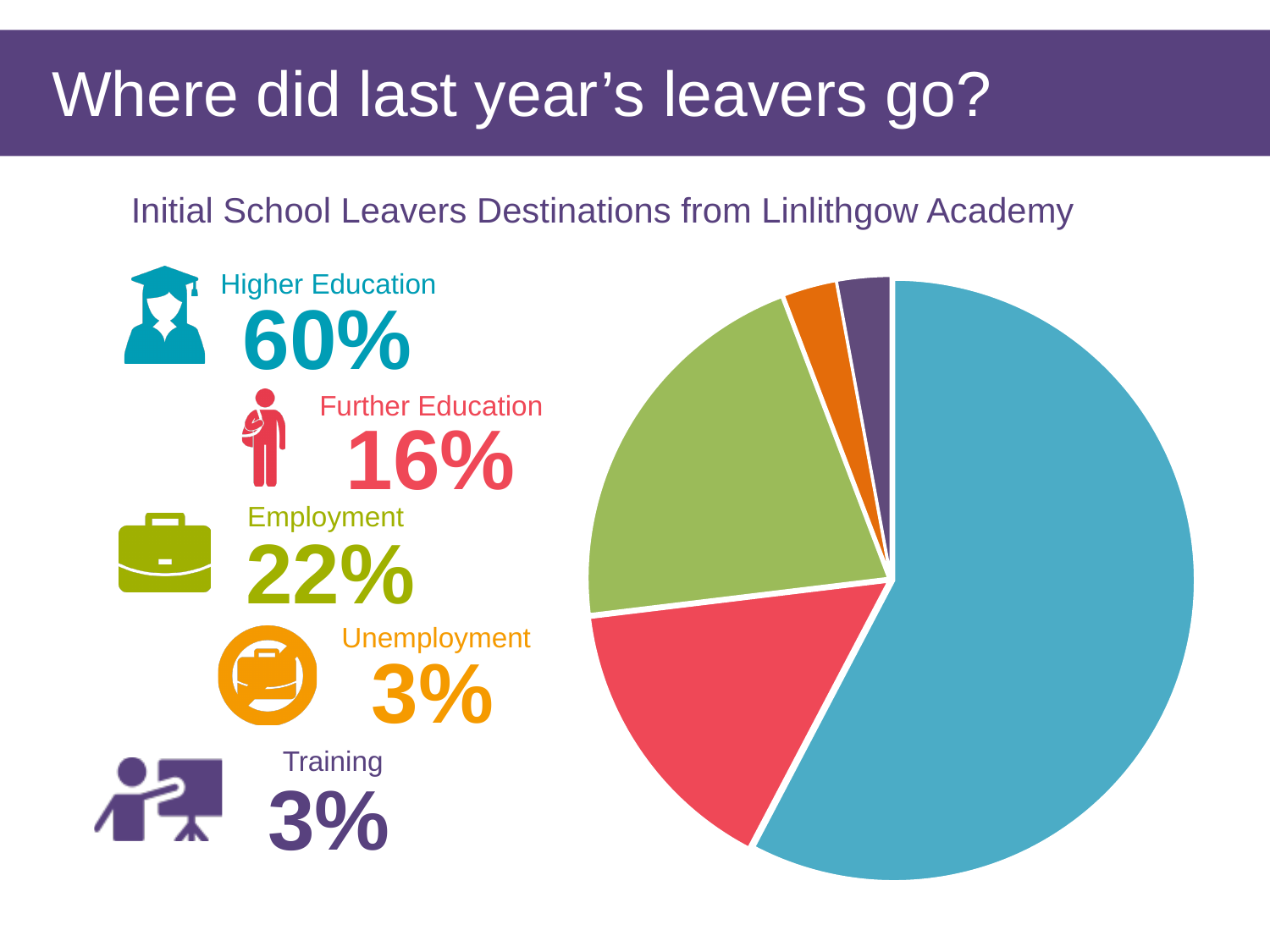
What is the difference between the Employment and Further Education percentages? 6% Which destination has the largest share of leavers? Higher Education What is the combined percentage of leavers in Unemployment and Training? 6% What is the difference between the Higher Education and Employment percentages? 38% Which is larger, the share for Employment or the share for Further Education? Employment What kind of chart is shown on the slide? pie chart How many destination categories are shown in the pie chart? 5 What percentage of leavers went to Further Education? 16% What percentage of leavers went into Employment? 22% What percentage of leavers went into Training? 3% What is the title of the chart? Initial School Leavers Destinations from Linlithgow Academy What percentage of leavers went to Higher Education? 60%